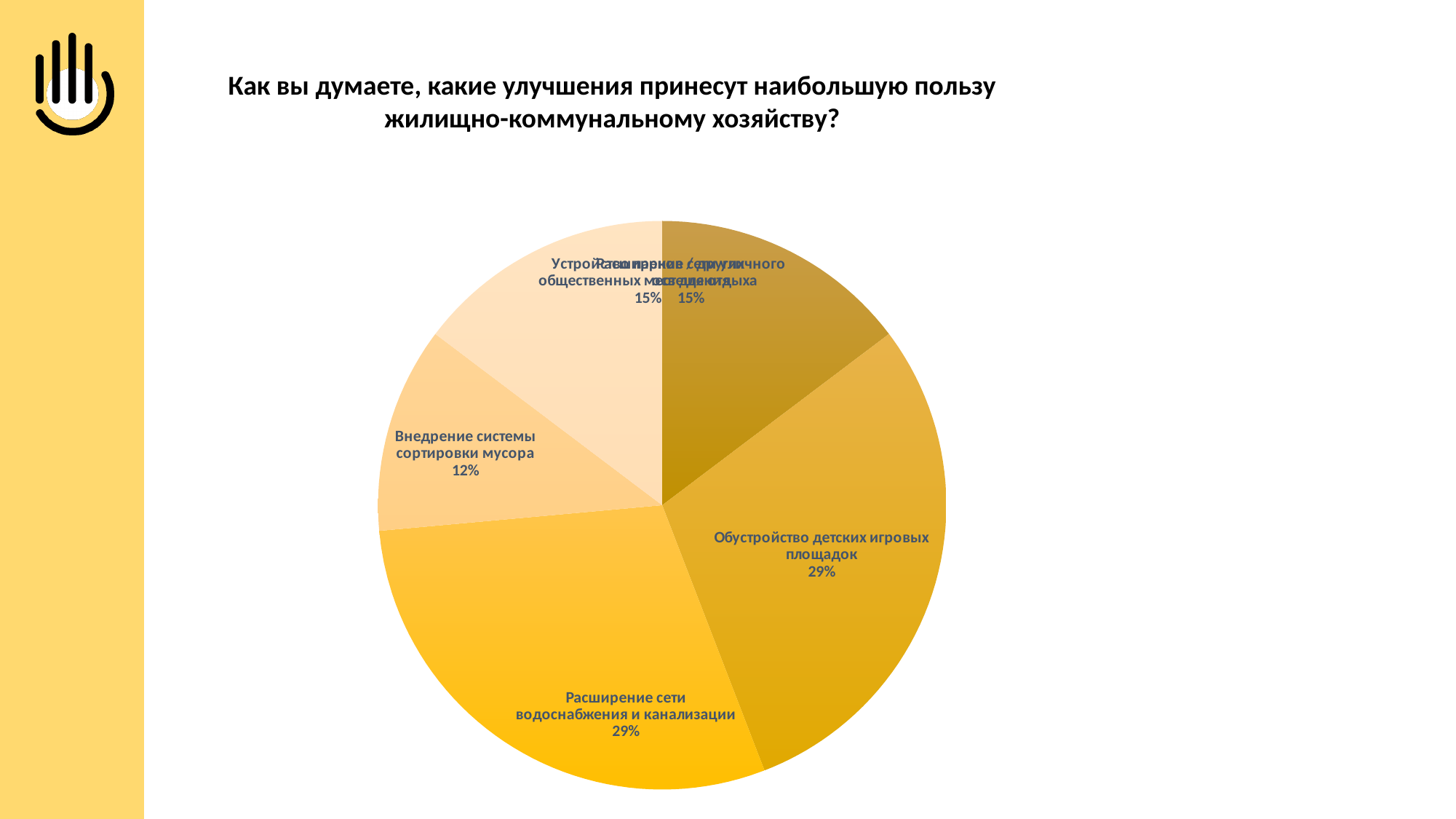
What percentage is shown for "Внедрение системы сортировки мусора"? 12% What combined share of the pie do "Обустройство детских игровых площадок" and "Расширение сети водоснабжения и канализации" make up? 58% How many slices are labelled 29%? 2 What kind of chart is shown on the slide? pie chart Which is larger: "Расширение сети водоснабжения и канализации" or "Внедрение системы сортировки мусора"? Расширение сети водоснабжения и канализации What percentage is shown for "Обустройство детских игровых площадок"? 29% How many slices does the pie chart have? 5 Which category has the smallest slice of the pie? Внедрение системы сортировки мусора What question is posed in the title above the chart? Как вы думаете, какие улучшения принесут наибольшую пользу жилищно-коммунальному хозяйству? What percentage is shown for "Расширение сети водоснабжения и канализации"? 29% What is the difference in percentage points between "Обустройство детских игровых площадок" and "Внедрение системы сортировки мусора"? 17 percentage points Which two categories share the largest slice of the pie? Обустройство детских игровых площадок and Расширение сети водоснабжения и канализации